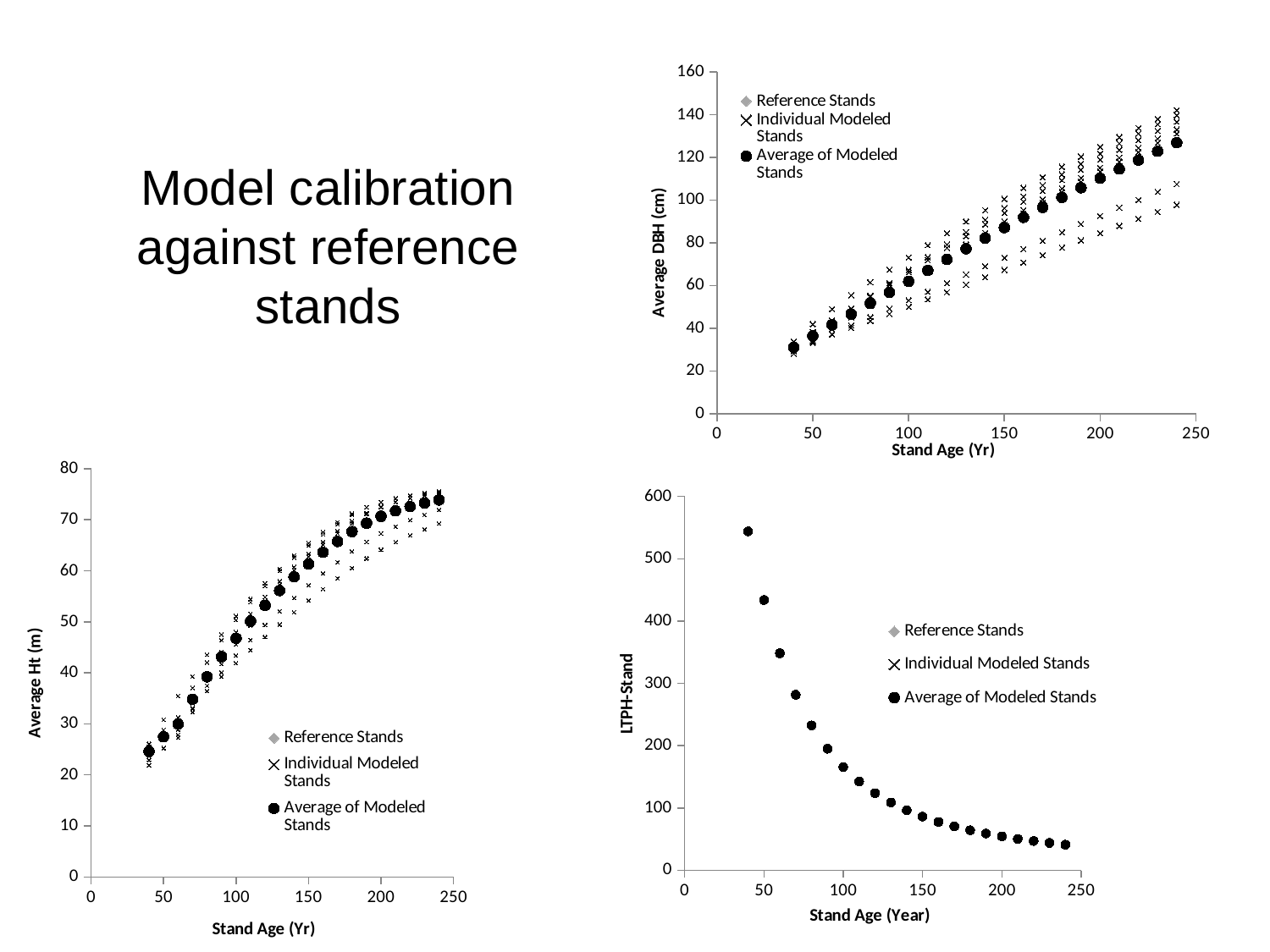
In the top-right chart (Average DBH), is the Average of Modeled Stands value at stand age 240 greater or less than 100? greater In the top-right chart (Average DBH), do the Average of Modeled Stands values rise or fall as stand age increases? rise In the bottom-left chart (Average Ht), which is larger for Average of Modeled Stands: the value at stand age 100 or at stand age 200? stand age 200 In the bottom-right chart (LTPH-Stand), do the Average of Modeled Stands values rise or fall as stand age increases? fall How many charts are shown on the slide? 3 In the bottom-left chart (Average Ht), is the Average of Modeled Stands value at stand age 40 greater or less than 30? less In the bottom-right chart (LTPH-Stand), is the Average of Modeled Stands value at stand age 240 greater or less than 100? less How many series does the legend of the top-right chart (Average DBH) list? 3 What is the y-axis title of the bottom-left chart? Average Ht (m) What kind of chart is the bottom-right chart (LTPH-Stand vs Stand Age)? scatter chart